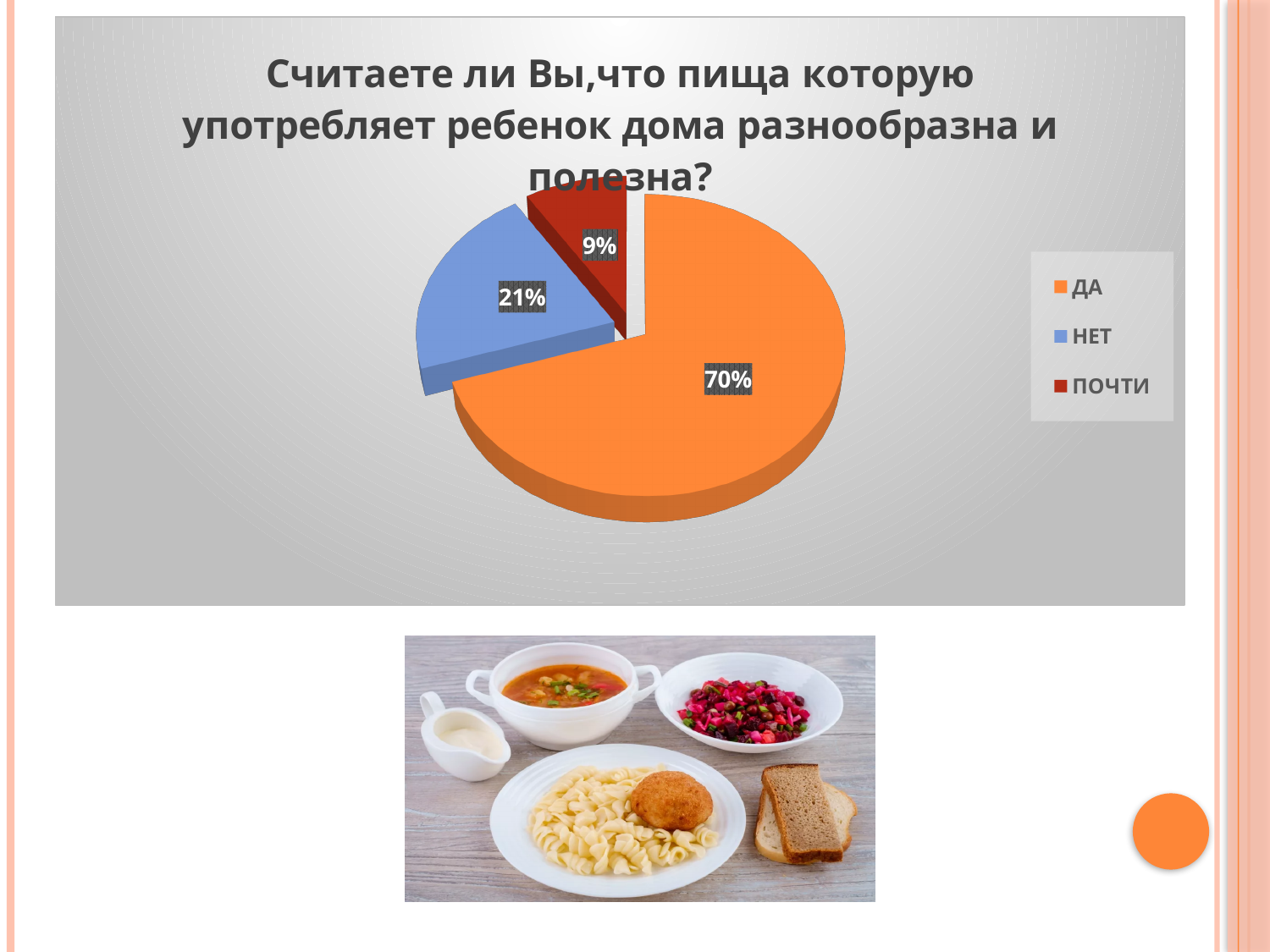
What share of the pie does the ДА slice represent? 70% What is the difference in percentage points between the ДА and НЕТ slices? 49 Which slice is larger, НЕТ or ПОЧТИ? НЕТ What share of the pie does the НЕТ slice represent? 21% What kind of chart is shown on the slide? pie chart Which legend entry is shown in blue? НЕТ Which category has the largest slice of the pie? ДА How many categories does the pie chart show? 3 What colour is the ДА slice in the pie chart? orange What share of the pie does the ПОЧТИ slice represent? 9% What is the difference in percentage points between the НЕТ and ПОЧТИ slices? 12 Which category has the smallest slice of the pie? ПОЧТИ